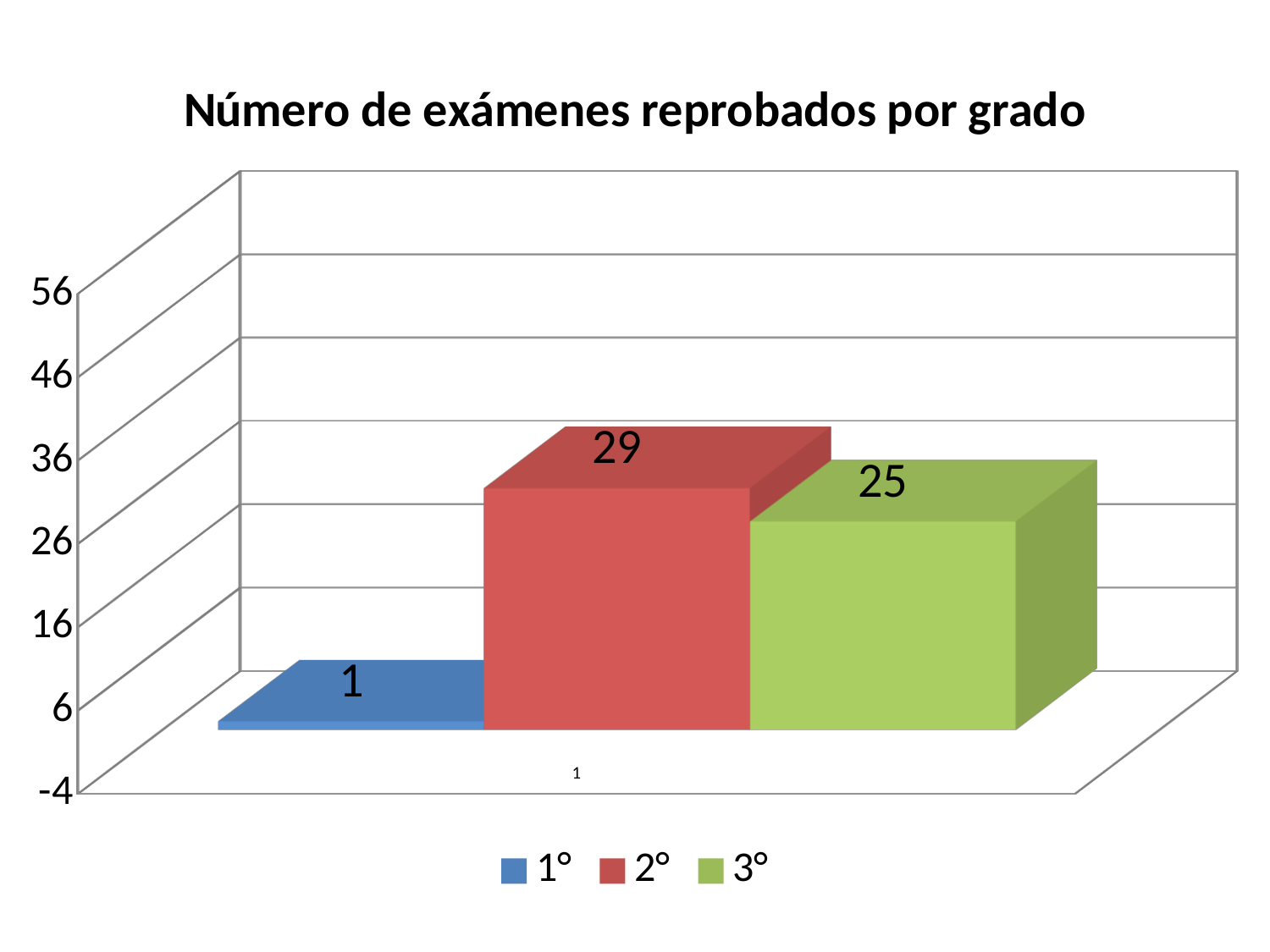
What colour is the bar for 2°? Red What is the title of the chart? Número de exámenes reprobados por grado What is the difference between the values for 2° and 3°? 4 What is the value for 2° in the chart? 29 Which series has the lowest value? 1° What is the difference between the values for 2° and 1°? 28 How many series does the legend list? 3 What kind of chart is shown on the slide? Bar chart What is the value for 3° in the chart? 25 Which is larger, the value for 3° or the value for 1°? 3° Which series has the highest value? 2° What is the value for 1° in the chart? 1